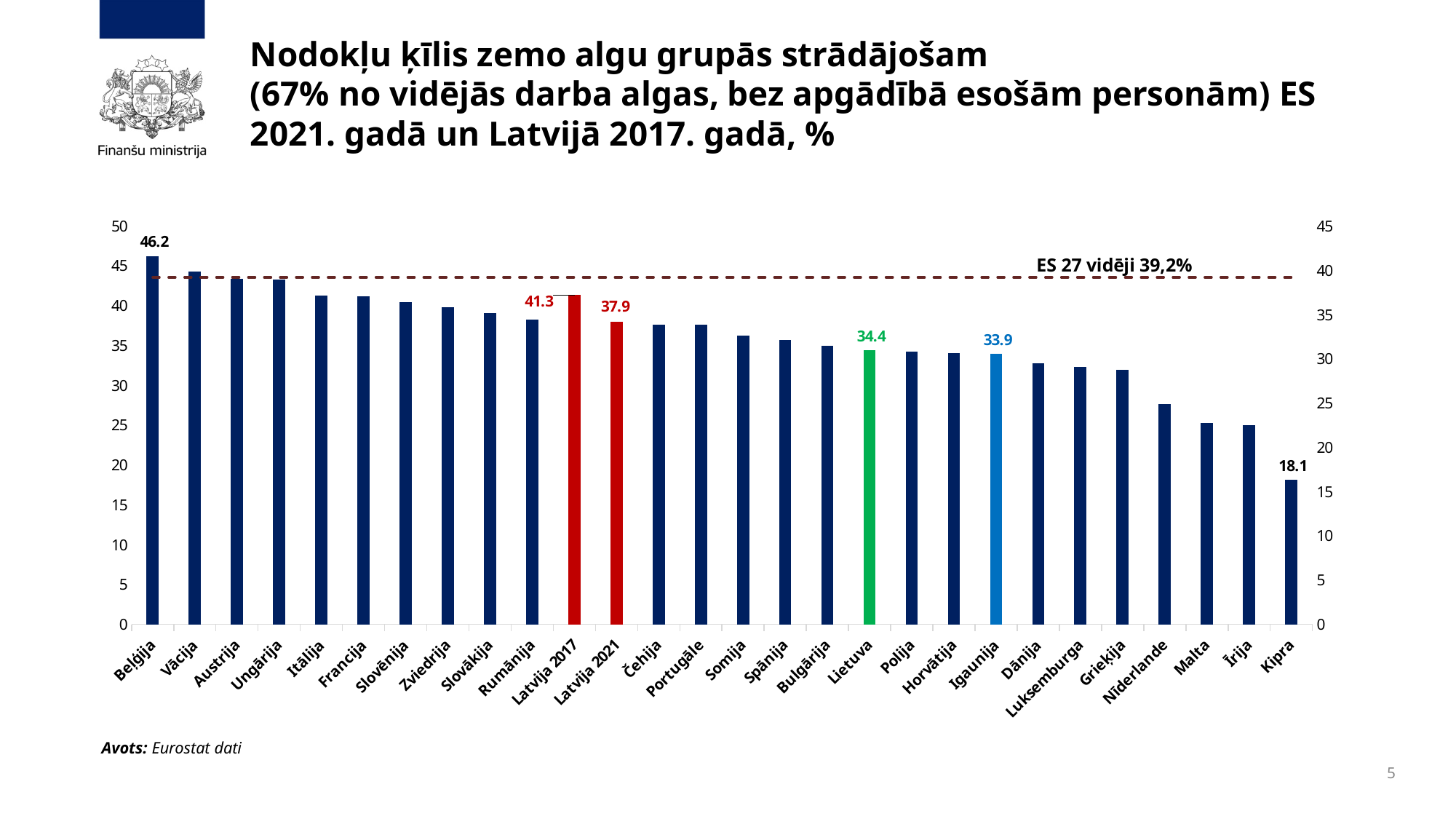
How many bars are shown in the chart? 28 Which country has the lowest value? Kipra Which is larger, the value for Lietuva or the value for Igaunija? Lietuva What is the value for Beļģija? 46.2 What is the ES 27 average value shown by the dashed line? 39,2% What is the value for Latvija 2021? 37.9 What is the value for Igaunija? 33.9 Which country has the highest value? Beļģija What is the value for Lietuva? 34.4 What is the difference between the values for Latvija 2017 and Latvija 2021? 3.4 Is the value for Malta greater or less than 30? less What is the value for Latvija 2017? 41.3